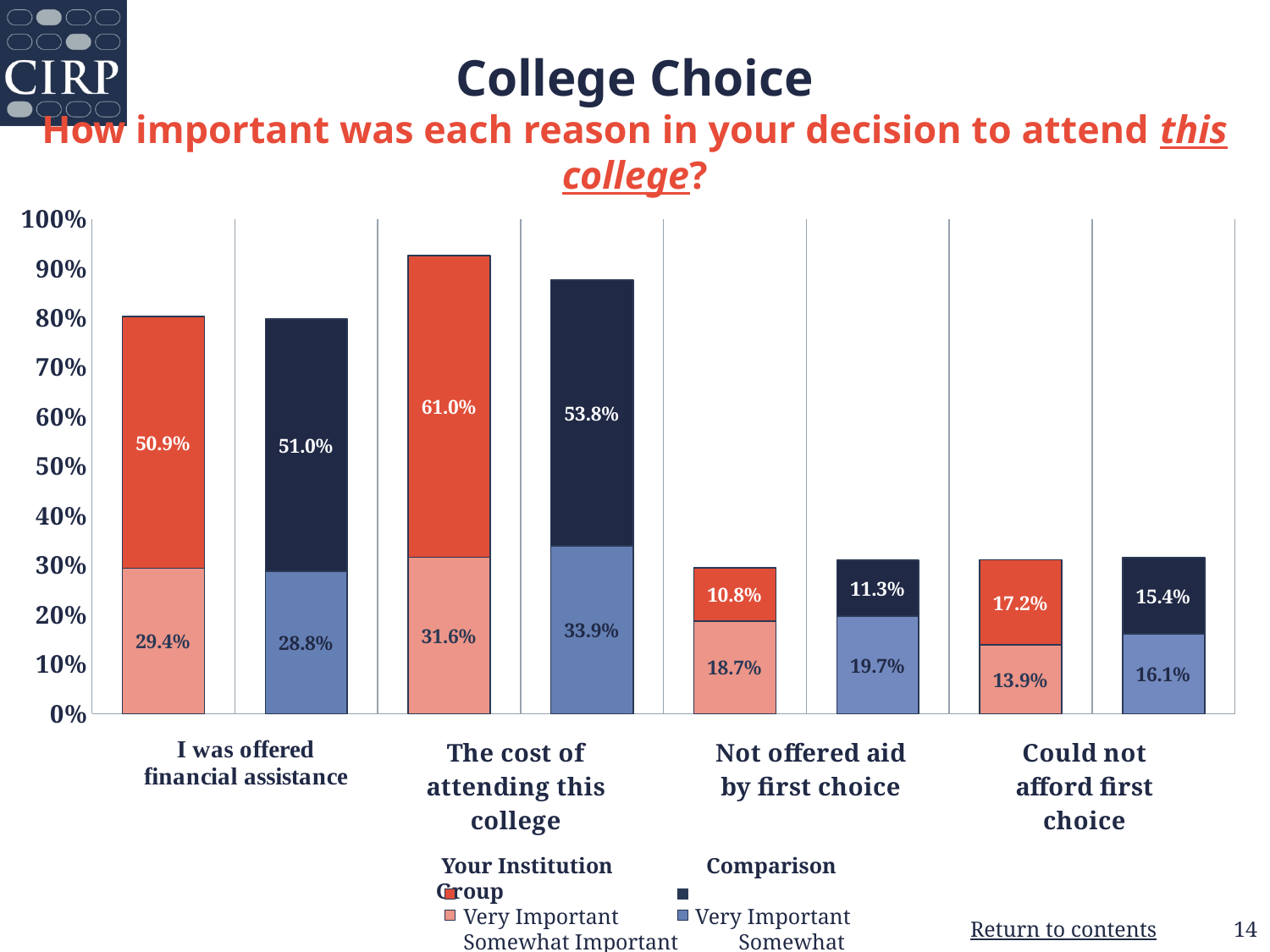
What percentage of Comparison Group respondents rated "I was offered financial assistance" as Somewhat Important? 28.8% Which reason has the highest Very Important percentage for Your Institution? The cost of attending this college What percentage of Your Institution respondents rated "The cost of attending this college" as Very Important? 61.0% Which reason has the lowest Very Important percentage for the Comparison Group? Not offered aid by first choice What is the total (Very Important plus Somewhat Important) for the Comparison Group on "I was offered financial assistance"? 79.8% What is the Somewhat Important percentage for Your Institution on "Not offered aid by first choice"? 18.7% What kind of chart is shown on the slide? Stacked bar chart What is the total (Very Important plus Somewhat Important) for Your Institution on "The cost of attending this college"? 92.6% What is the difference between the Your Institution and Comparison Group Very Important percentages for "The cost of attending this college"? 7.2% For "Could not afford first choice", is the Very Important percentage larger for Your Institution or the Comparison Group? Your Institution What is the Very Important percentage for the Comparison Group on "Could not afford first choice"? 15.4% How many reasons (categories) are shown on the x axis of the chart? 4